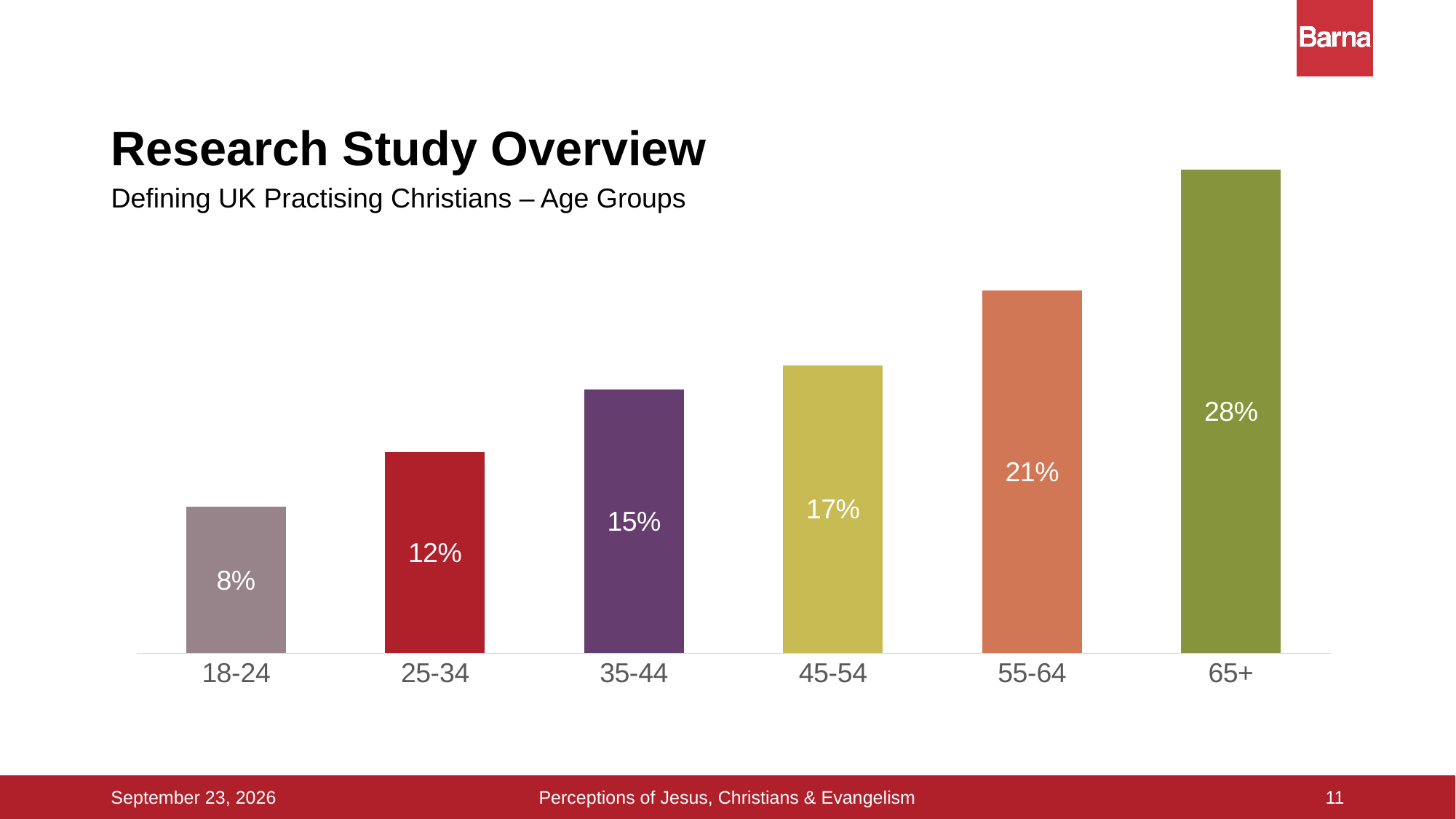
What is the subtitle of the chart on the slide? Defining UK Practising Christians – Age Groups What is the difference between the values for 65+ and 18-24? 20% Which is larger, the value for 25-34 or the value for 45-54? 45-54 What is the value for the 45-54 age group? 17% How many age groups are shown in the chart? 6 What is the difference between the values for 35-44 and 25-34? 3% Which age group has the lowest value? 18-24 What is the value for the 55-64 age group? 21% Do the values rise or fall as the age groups get older along the x axis? Rise What is the value for the 18-24 age group? 8% Which age group has the highest value? 65+ What kind of chart is shown on the slide? Bar chart